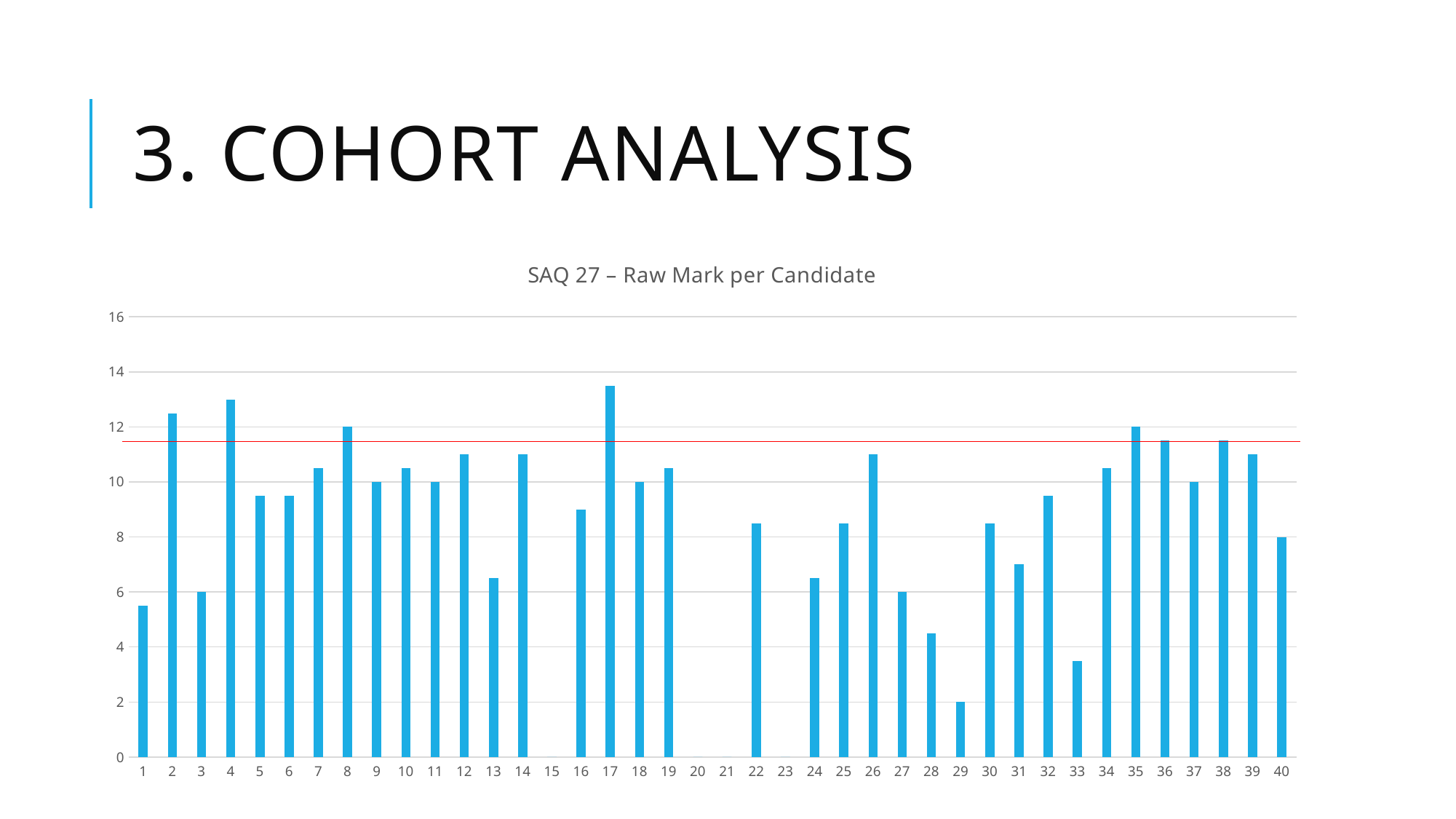
What is the raw mark for candidate 40? 8 Which candidate has the highest raw mark? 17 Is the raw mark for candidate 33 greater or less than 4? less Among candidates with a bar shown, which candidate has the lowest raw mark? 29 Is the raw mark for candidate 4 greater or less than 12? greater What type of chart is shown on the slide? Bar chart What colour is the horizontal reference line drawn across the chart? Red What is the raw mark for candidate 3? 6 What is the title of the chart? SAQ 27 – Raw Mark per Candidate Which candidate has the higher raw mark, candidate 2 or candidate 28? 2 What is the raw mark for candidate 29? 2 How many candidates are labelled along the x axis? 40